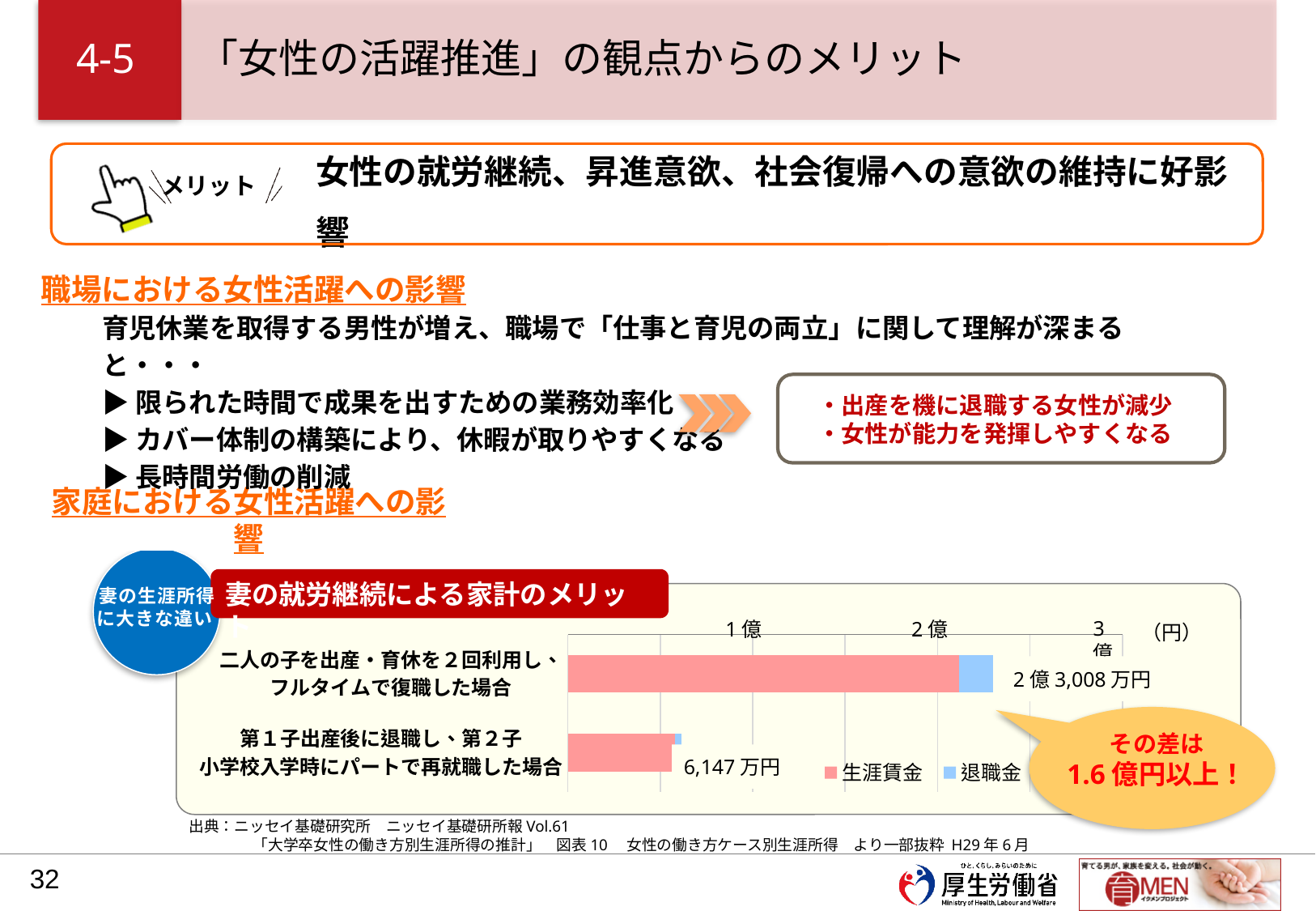
How many series does the chart's legend list? 2 What is the title of the chart? 妻の就労継続による家計のメリット What is the total value shown for 「第１子出産後に退職し、第２子小学校入学時にパートで再就職した場合」? 6,147万円 Which case has the higher total lifetime income in the chart? 二人の子を出産・育休を２回利用し、フルタイムで復職した場合 Which case has the lower total lifetime income in the chart? 第１子出産後に退職し、第２子小学校入学時にパートで再就職した場合 Is the total for 「第１子出産後に退職し、第２子小学校入学時にパートで再就職した場合」 greater or less than 1億? less Is the total for 「二人の子を出産・育休を２回利用し、フルタイムで復職した場合」 greater or less than 2億? greater What are the two series named in the chart's legend? 生涯賃金, 退職金 What kind of chart is shown on the slide? bar chart What is the total value shown for 「二人の子を出産・育休を２回利用し、フルタイムで復職した場合」? 2億3,008万円 How many categories (cases) are plotted in the chart? 2 What is the difference between the two totals shown in the chart (2億3,008万円 and 6,147万円)? 1億6,861万円